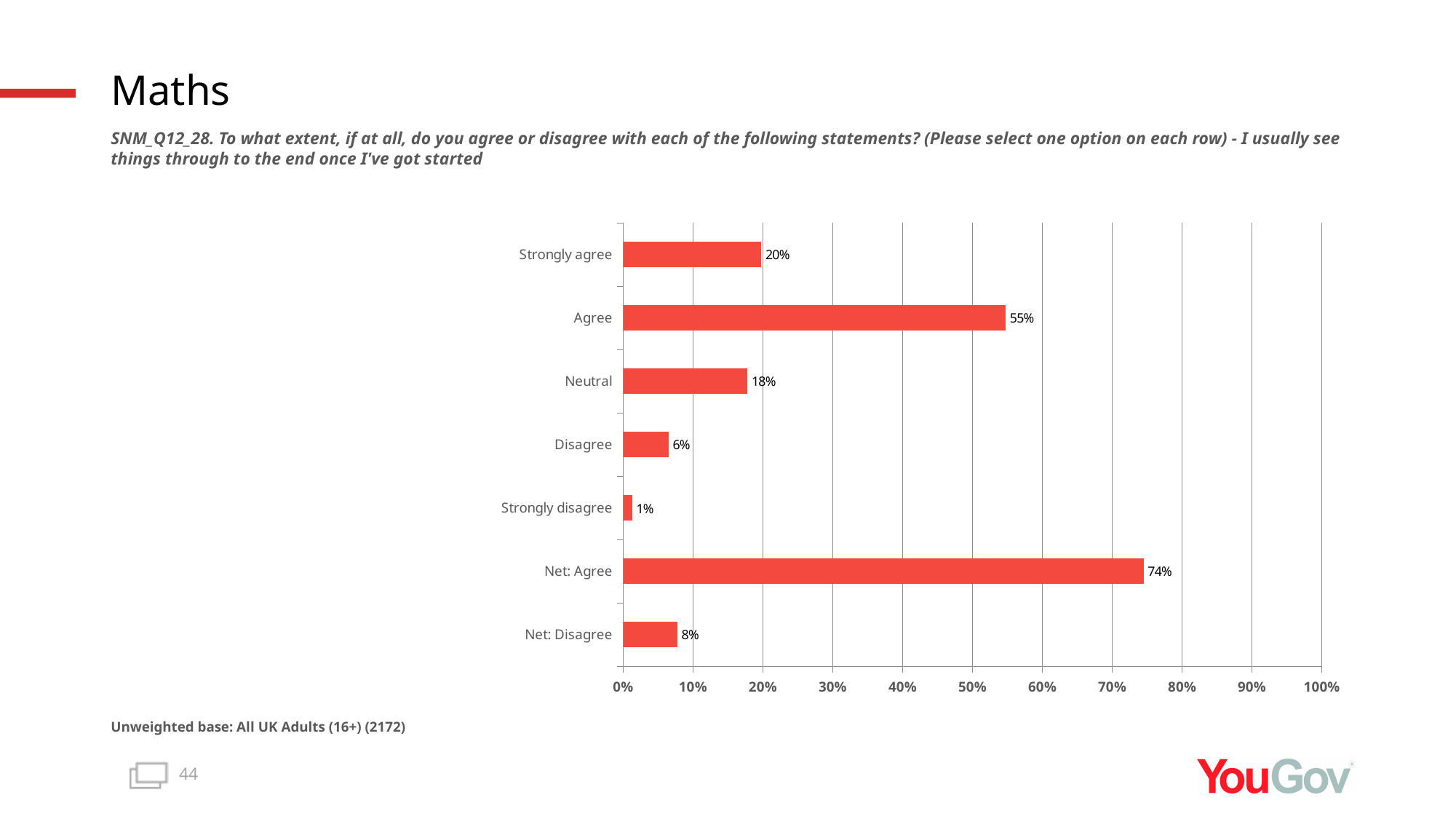
Which category has the highest value? Net: Agree Which is larger, 'Disagree' or 'Neutral'? Neutral Which category has the lowest value? Strongly disagree What is the difference between 'Agree' and 'Strongly agree'? 35% What percentage of respondents selected 'Agree'? 55% What is the value shown for 'Strongly disagree'? 1% How many categories are shown on the chart? 7 Is the value for 'Agree' greater or less than 50%? greater What is the value for 'Net: Agree'? 74% What is the difference between 'Net: Agree' and 'Net: Disagree'? 66% What percentage of respondents were 'Neutral'? 18% What type of chart is shown on the slide? Bar chart